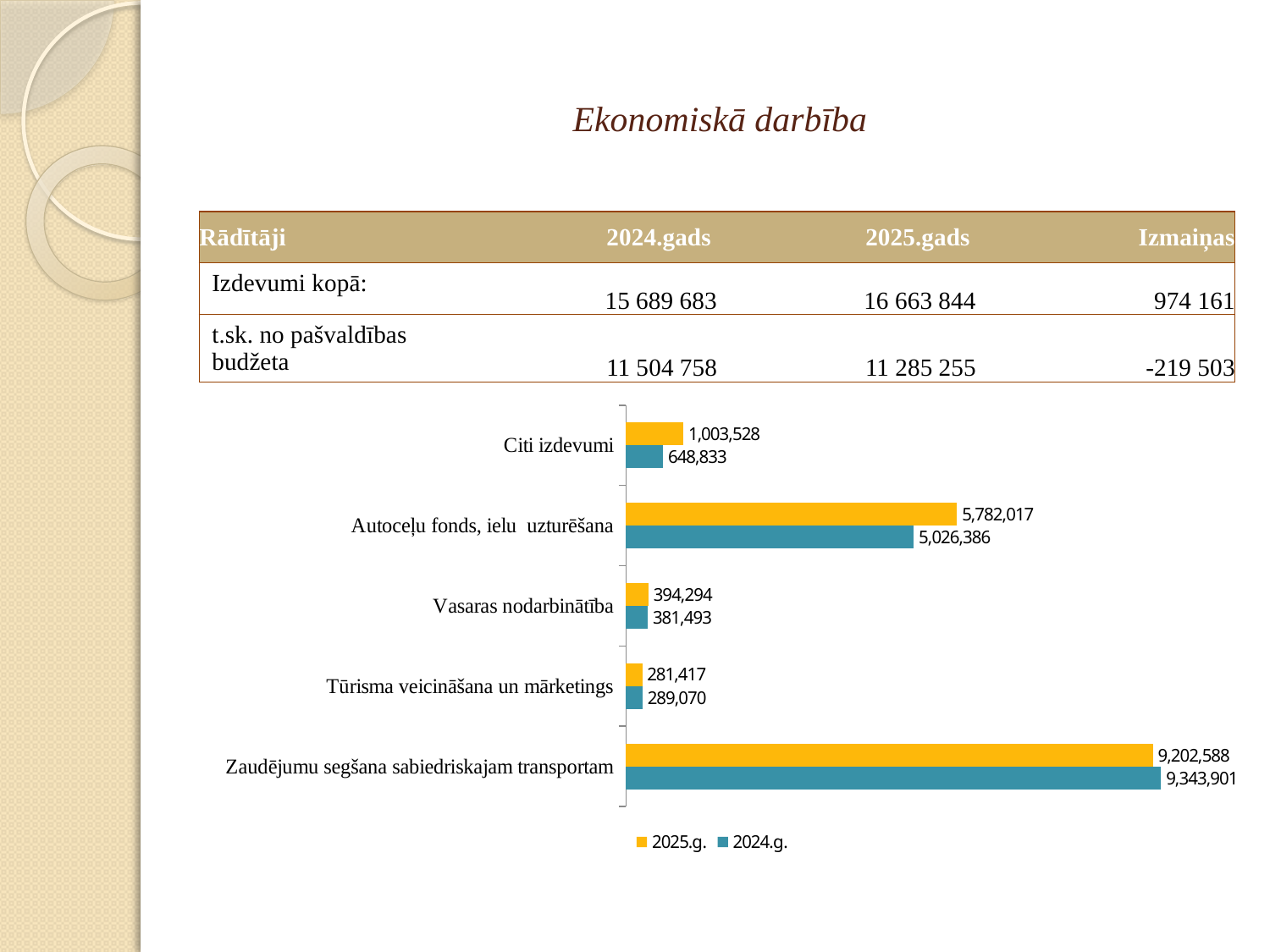
What is the difference between the 2025.g. and 2024.g. values for Citi izdevumi? 354,695 What is the 2025.g. value for Citi izdevumi? 1,003,528 What is the 2024.g. value for Zaudējumu segšana sabiedriskajam transportam? 9,343,901 What is the 2025.g. value for Vasaras nodarbinātība? 394,294 How many series does the chart legend list? 2 Which category has the lowest 2024.g. value? Tūrisma veicināšana un mārketings What is the difference between the 2025.g. and 2024.g. values for Autoceļu fonds, ielu uzturēšana? 755,631 What kind of chart is shown on the slide? Bar chart What is the 2024.g. value for Autoceļu fonds, ielu uzturēšana? 5,026,386 For Tūrisma veicināšana un mārketings, which is larger: the 2025.g. value or the 2024.g. value? 2024.g. Which category has the highest 2025.g. value? Zaudējumu segšana sabiedriskajam transportam How many categories are shown in the bar chart? 5